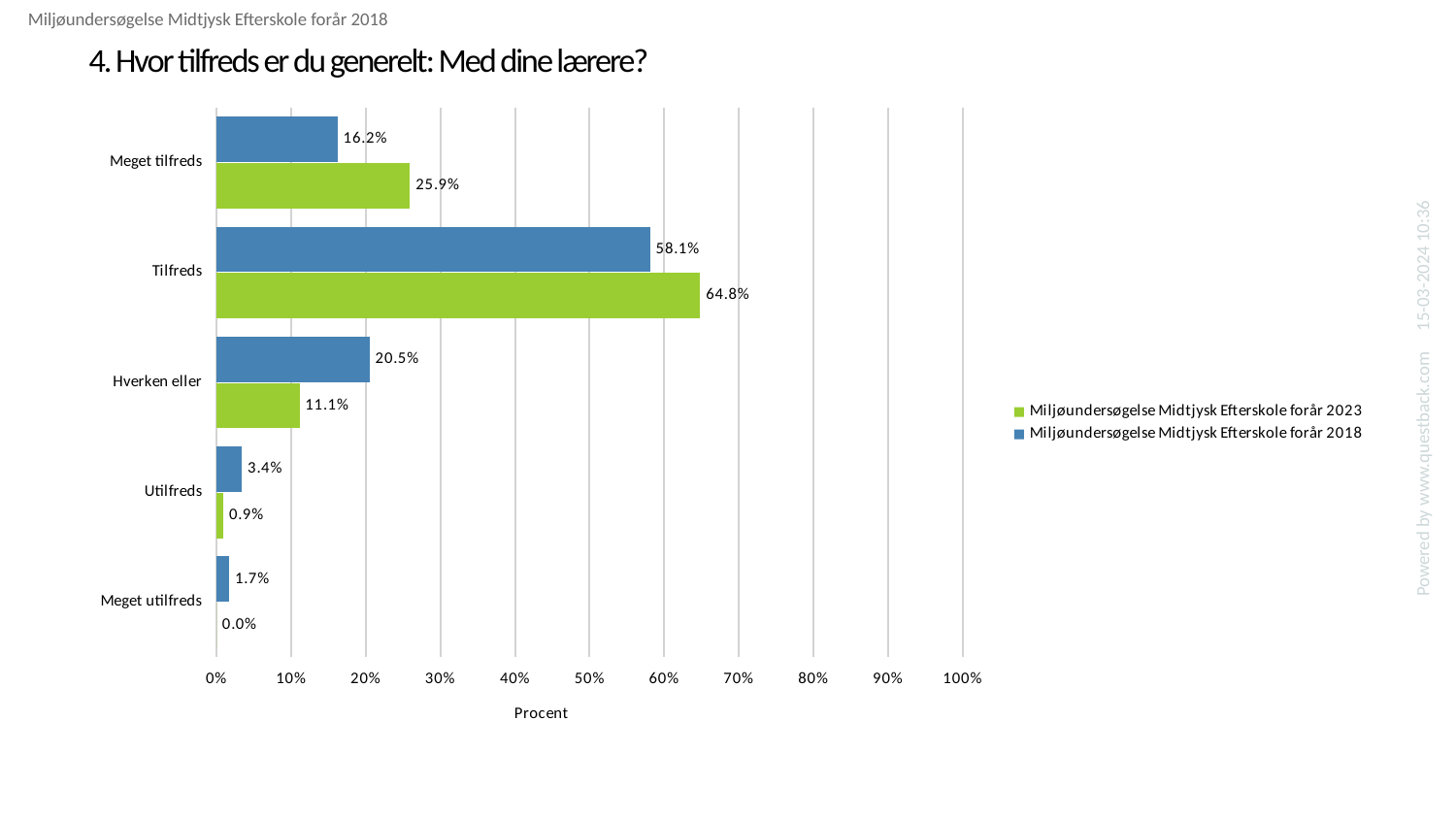
How many categories are shown on the y axis? 5 What is the label of the x axis? Procent Which category has the highest value in the 2023 series? Tilfreds For Hverken eller, which series has the larger value, 2018 or 2023? 2018 How many series does the legend list? 2 What is the value for Meget tilfreds in the 2018 series? 16.2% What is the value for Hverken eller in the Miljøundersøgelse Midtjysk Efterskole forår 2018 series? 20.5% What kind of chart is shown on the slide? Bar chart Which category has the lowest value in the 2018 series? Meget utilfreds What is the value for Meget utilfreds in the 2023 series? 0.0% What is the difference between the 2023 and 2018 values for Tilfreds? 6.7% What is the value for Tilfreds in the Miljøundersøgelse Midtjysk Efterskole forår 2023 series? 64.8%